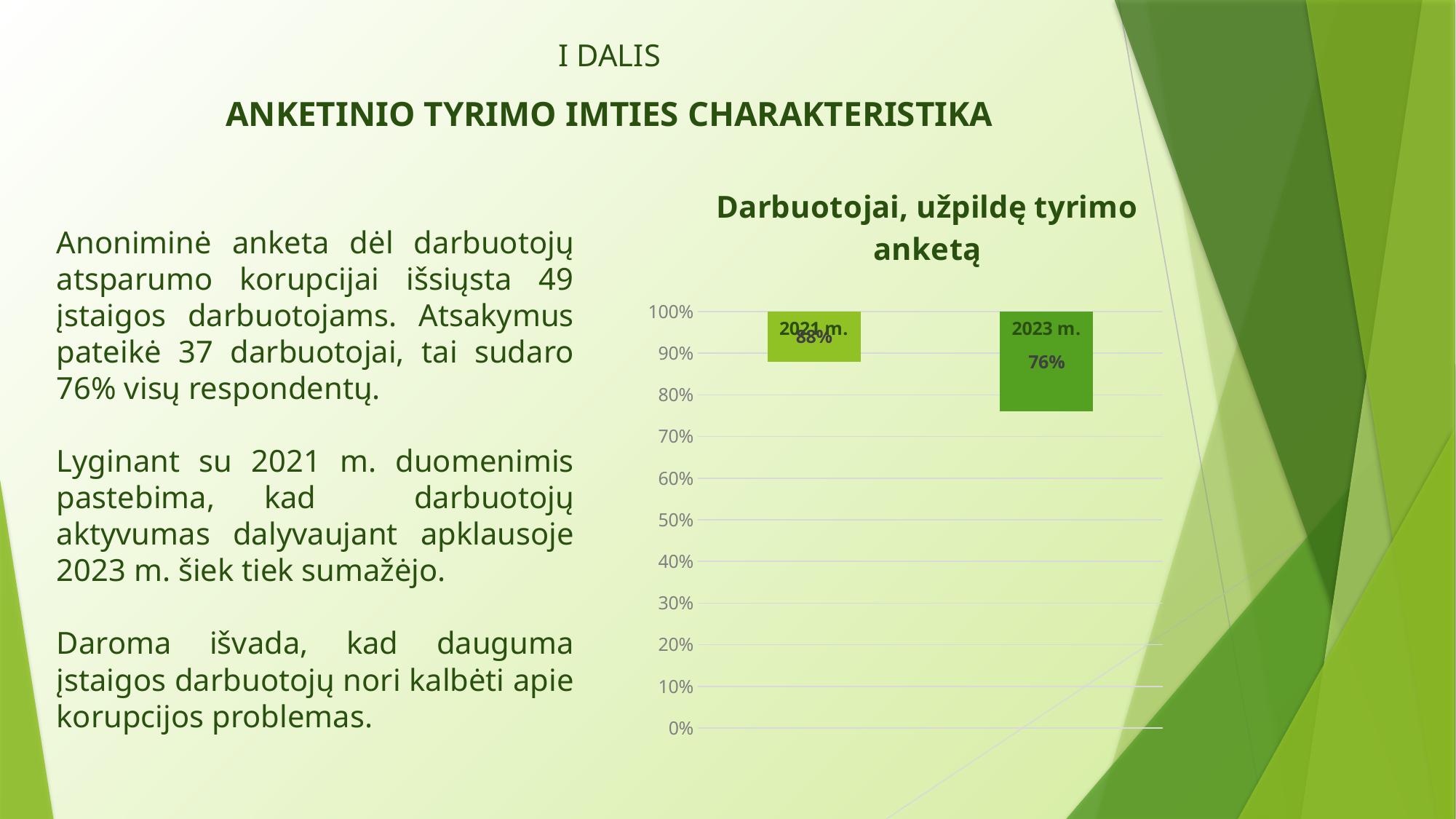
What kind of chart is shown on the slide? bar chart What is the highest value shown on the chart's vertical axis? 100% How many categories are shown in the chart? 2 Do the values in the chart rise or fall from 2021 m. to 2023 m.? fall What is the value for 2021 m. in the chart? 88% Is the value for 2023 m. greater or less than 80%? less What is the value for 2023 m. in the chart? 76% Which year has the higher value in the chart, 2021 m. or 2023 m.? 2021 m. Which category has the highest value in the chart? 2021 m. Which category has the lowest value in the chart? 2023 m. What is the difference between the 2021 m. and 2023 m. values in the chart? 12% What is the title of the chart? Darbuotojai, užpildę tyrimo anketą